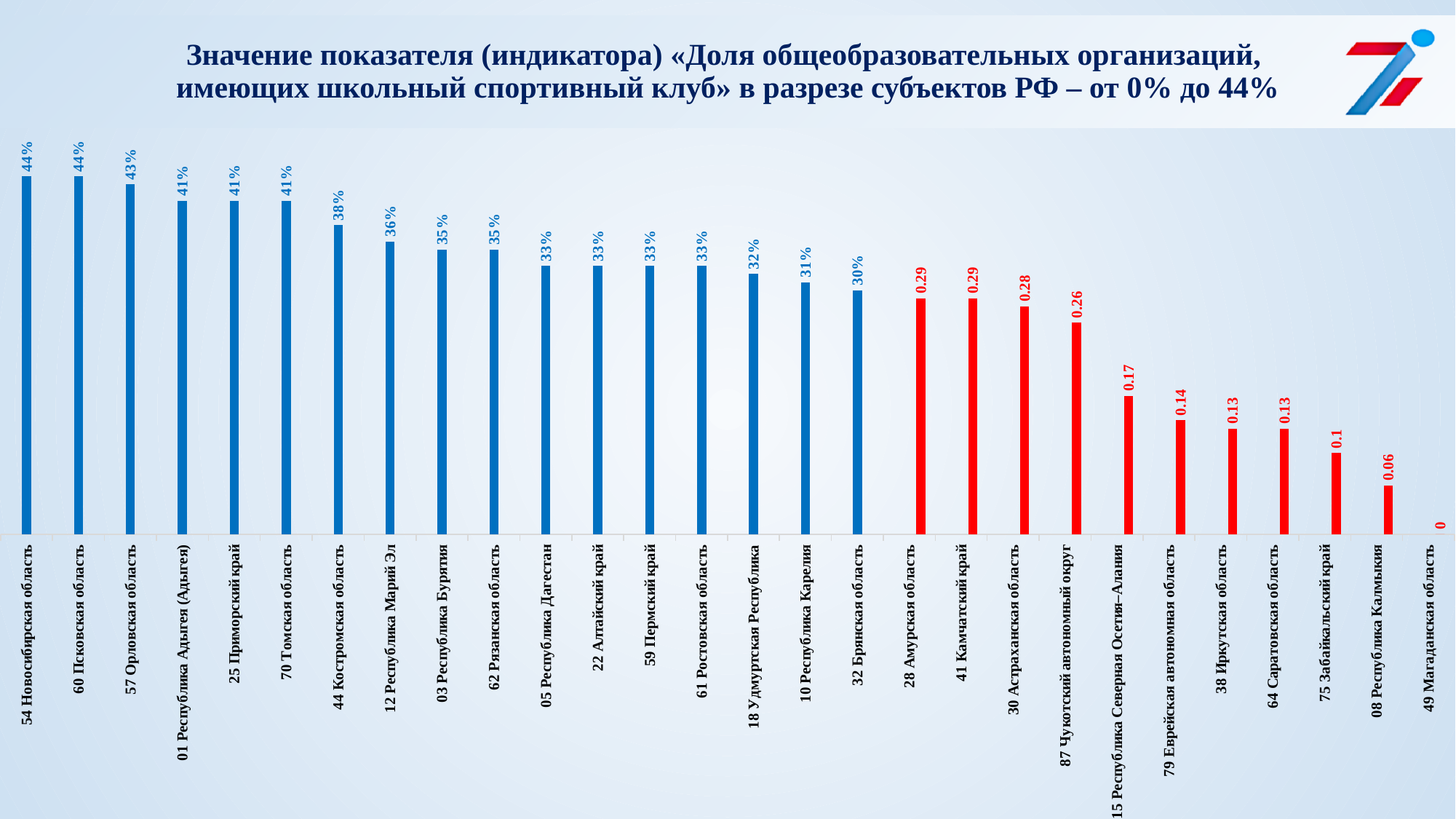
Which has the larger value, 70 Томская область or 12 Республика Марий Эл? 70 Томская область What kind of chart is shown on the slide? Bar chart Do the values rise or fall from left to right along the x axis? Fall How many regions are shown on the chart? 28 What colour are the bars for regions from 28 Амурская область onward? Red What is the value shown for 87 Чукотский автономный округ? 0.26 What is the value shown for 44 Костромская область? 38% What is the value shown for 08 Республика Калмыкия? 0.06 Which region has the lowest value on the chart? 49 Магаданская область What is the difference between the values for 44 Костромская область and 32 Брянская область? 8% What is the value shown for 57 Орловская область? 43% What is the value shown for 15 Республика Северная Осетия–Алания? 0.17